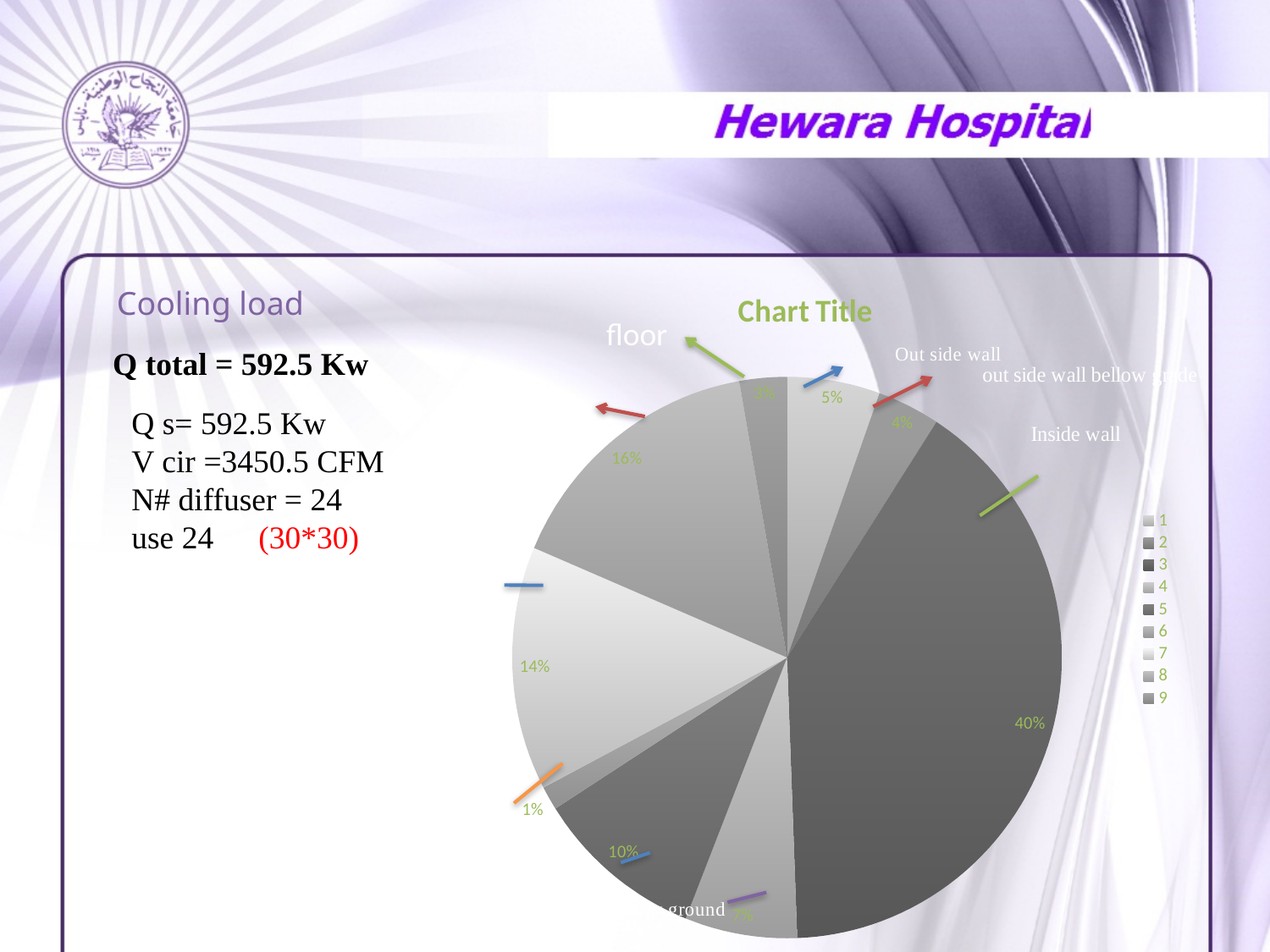
What is the title of the chart on the slide? Chart Title What percentage is shown on the slice that the 'Out side wall' arrow points to? 5% What is the difference between the 16% slice and the 10% slice? 6% How many entries does the chart's legend list? 9 Is the largest slice of the pie chart greater or less than 30%? greater Which is larger, the 16% slice or the 14% slice? 16% How many slices does the pie chart have? 9 What percentage is shown on the slice that the 'Inside wall' arrow points to? 40% What is the largest percentage shown on any slice of the pie chart? 40% What is the smallest percentage shown on any slice of the pie chart? 1% What kind of chart is shown on the slide? pie chart What is the difference between the largest slice (40%) and the smallest slice (1%) of the pie chart? 39%